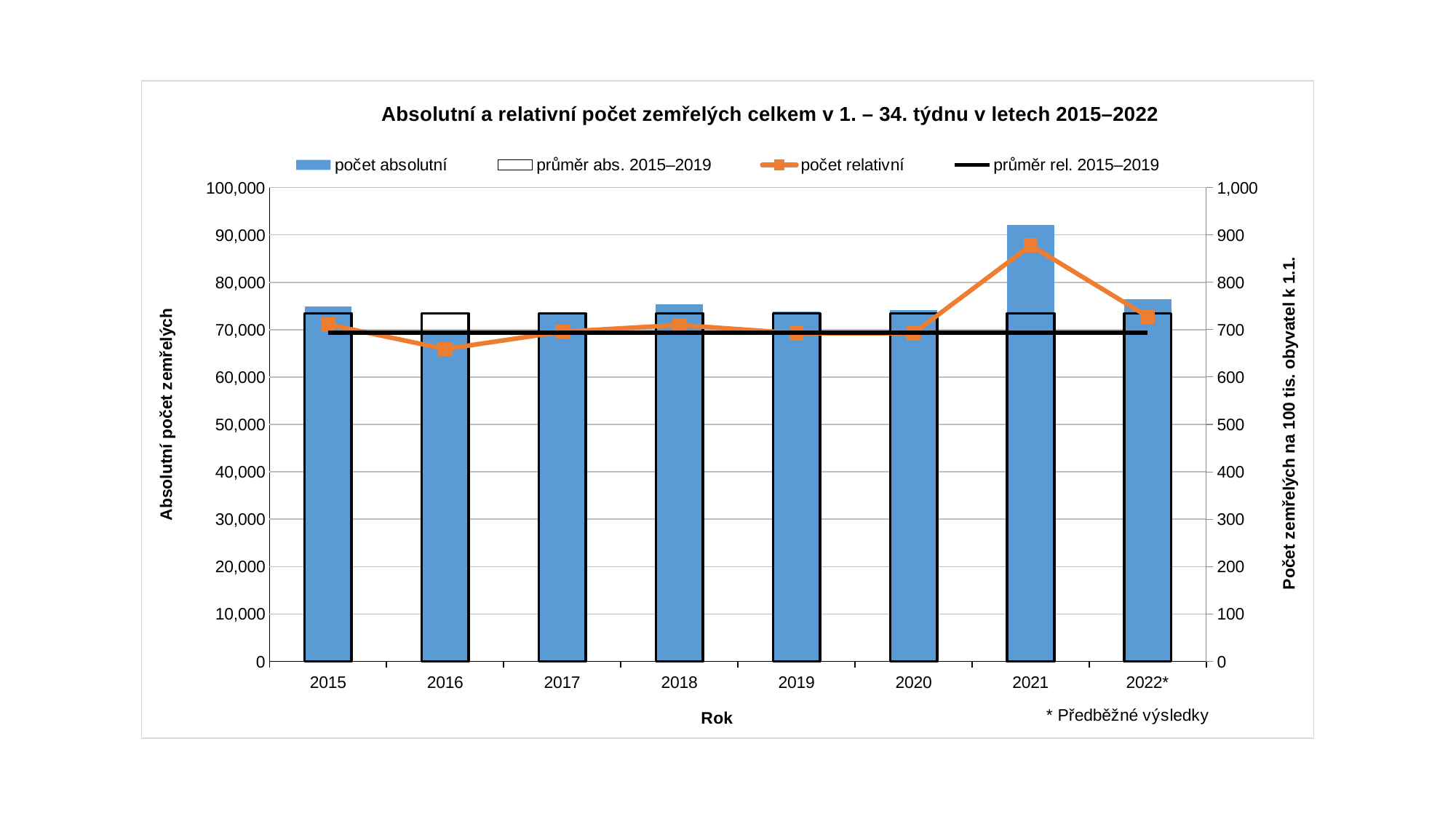
What kind of chart is shown on the slide? A combined bar and line chart Which year has a larger absolute number of deaths, 2021 or 2022*? 2021 Is the absolute number of deaths in 2021 greater or less than 80,000? greater How many series does the chart legend list? 4 Does the relative number of deaths rise or fall from 2021 to 2022*? fall What is the title of the right-hand vertical axis? Počet zemřelých na 100 tis. obyvatel k 1.1. How many years are shown on the x axis of the chart? 8 Which year has the lowest absolute number of deaths (počet absolutní)? 2016 Is the relative number of deaths (počet relativní) in 2016 greater or less than 700? less Is the relative number of deaths (počet relativní) in 2021 greater or less than 800? greater Which year has the highest absolute number of deaths (počet absolutní)? 2021